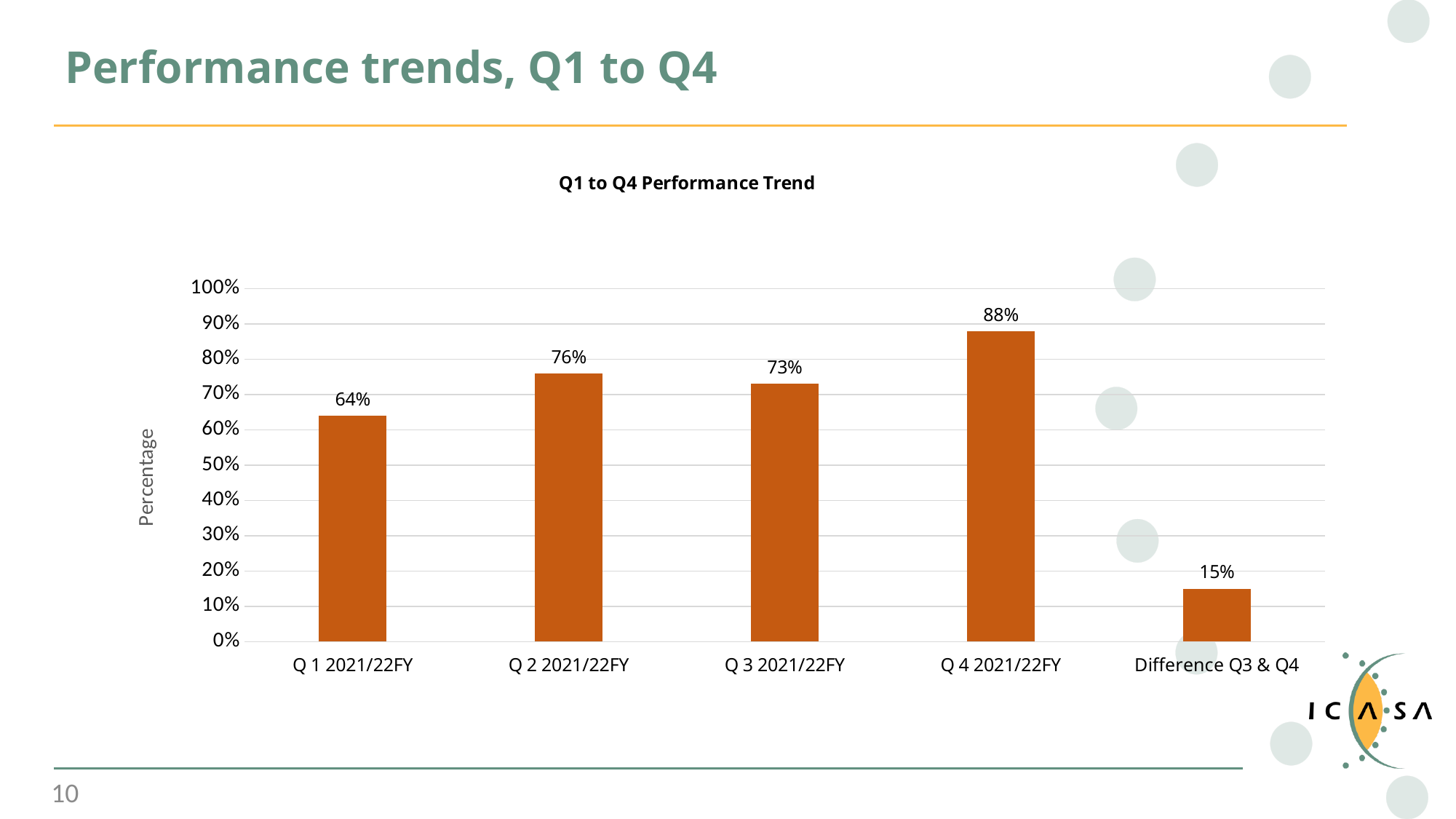
What is the difference between the values for Q 2 2021/22FY and Q 1 2021/22FY? 12% What is the value for Q 3 2021/22FY? 73% Which category has the lowest value? Difference Q3 & Q4 What is the value for Q 1 2021/22FY? 64% How many bars are plotted in the chart? 5 What is the value for Q 2 2021/22FY? 76% What kind of chart is shown on the slide? Bar chart What is the title of the chart? Q1 to Q4 Performance Trend What is the value for Q 4 2021/22FY? 88% Which category has the highest value? Q 4 2021/22FY Which is larger, the value for Q 2 2021/22FY or Q 3 2021/22FY? Q 2 2021/22FY What is the value shown for Difference Q3 & Q4? 15%